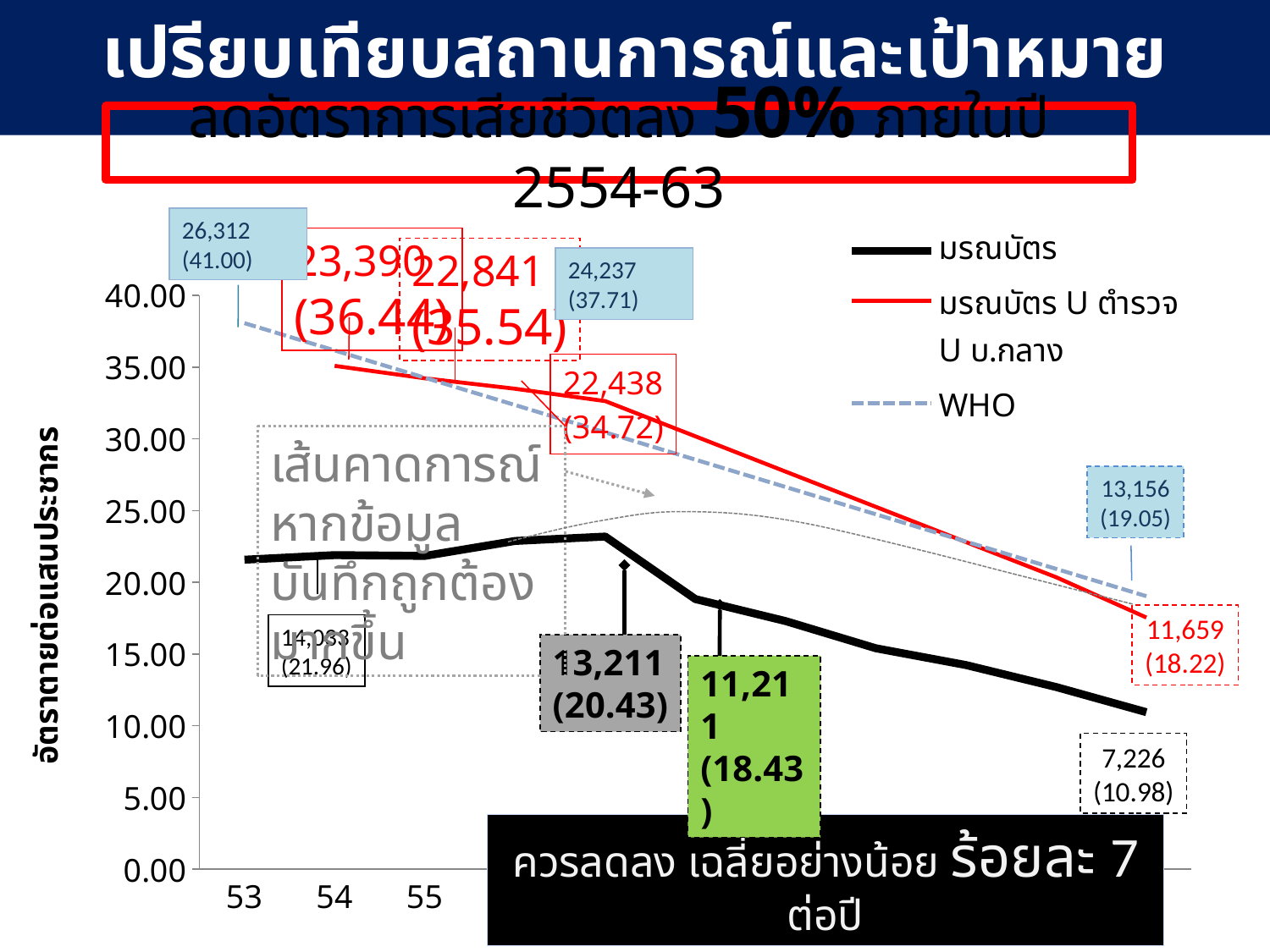
Is the value of the red line at x = 54 greater or less than 30.00? greater What value is printed in the blue label at the top left of the chart, above the start of the WHO dashed line? 26,312 (41.00) At the right end of the chart, which is higher: the red line or the black มรณบัตร line? the red line Is the value of the black มรณบัตร line at x = 53 greater or less than 20.00? greater Which series in the legend is drawn as a dashed line? WHO Is the value of the black มรณบัตร line at the right end of the chart greater or less than 15.00? less What kind of chart is shown on the slide? line chart How many series does the chart legend list? 3 What is the highest value shown on the y axis of the chart? 40.00 Does the WHO dashed line rise or fall from left to right across the chart? fall Does the red line (มรณบัตร U ตำรวจ U บ.กลาง) rise or fall from left to right across the chart? fall At x = 53, which is higher: the WHO dashed line or the black มรณบัตร line? WHO